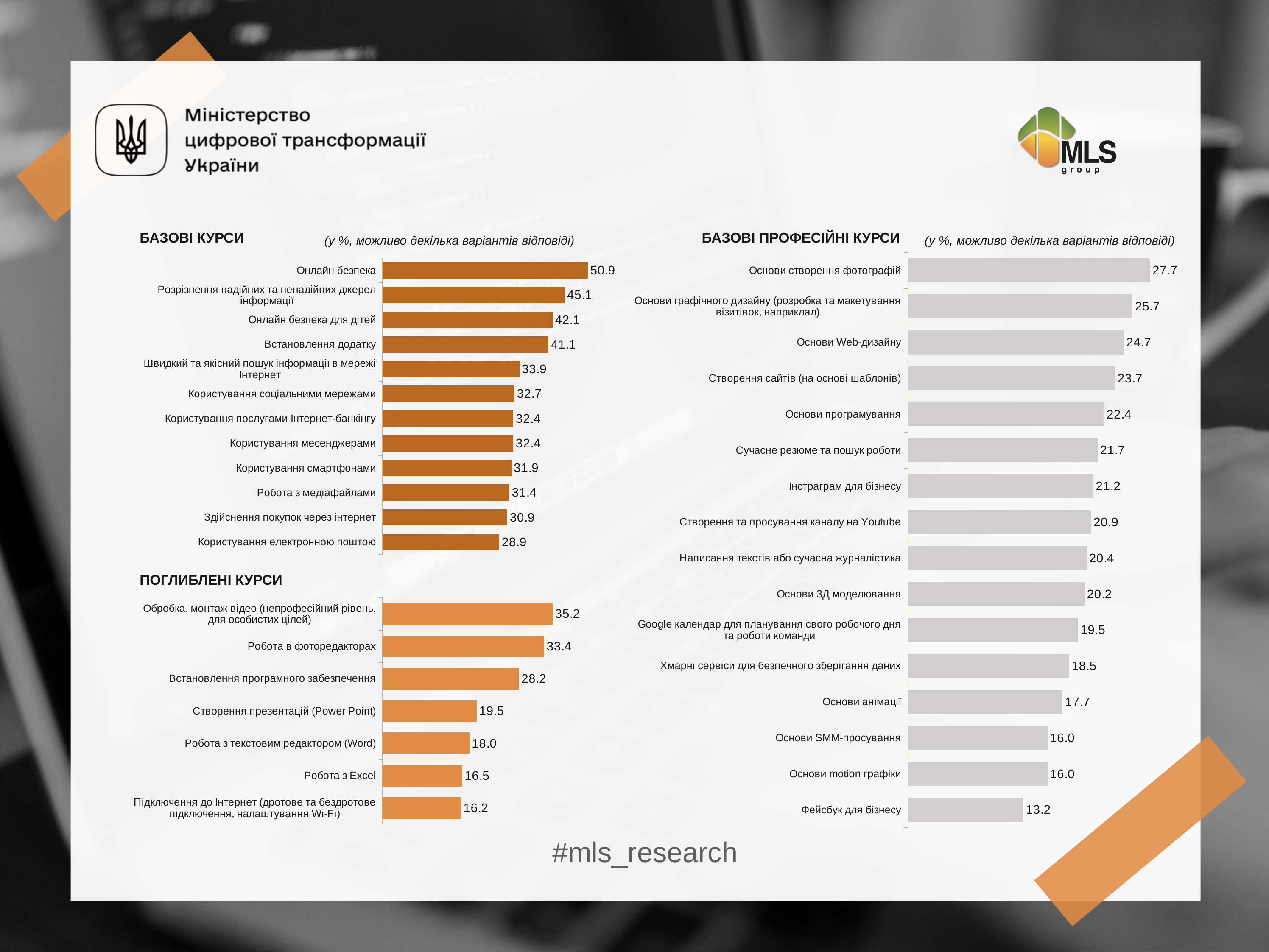
In the "БАЗОВІ КУРСИ" chart, what is the value for "Онлайн безпека"? 50.9 In the "ПОГЛИБЛЕНІ КУРСИ" chart, which category has the highest value? Обробка, монтаж відео (непрофесійний рівень, для особистих цілей) In the "БАЗОВІ КУРСИ" chart, which category has the lowest value? Користування електронною поштою What type of chart is the "БАЗОВІ ПРОФЕСІЙНІ КУРСИ" chart? Bar chart How many categories are shown in the "БАЗОВІ КУРСИ" chart? 12 In the "БАЗОВІ ПРОФЕСІЙНІ КУРСИ" chart, what is the value for "Основи програмування"? 22.4 In the "БАЗОВІ КУРСИ" chart, what is the difference between "Онлайн безпека" and "Онлайн безпека для дітей"? 8.8 In the "БАЗОВІ ПРОФЕСІЙНІ КУРСИ" chart, which category has the lowest value? Фейсбук для бізнесу In the "ПОГЛИБЛЕНІ КУРСИ" chart, which is larger: "Робота з Excel" or "Робота з текстовим редактором (Word)"? Робота з текстовим редактором (Word) How many categories are shown in the "ПОГЛИБЛЕНІ КУРСИ" chart? 7 In the "БАЗОВІ ПРОФЕСІЙНІ КУРСИ" chart, what is the difference between "Основи створення фотографій" and "Основи Web-дизайну"? 3.0 In the "ПОГЛИБЛЕНІ КУРСИ" chart, what is the value for "Робота в фоторедакторах"? 33.4